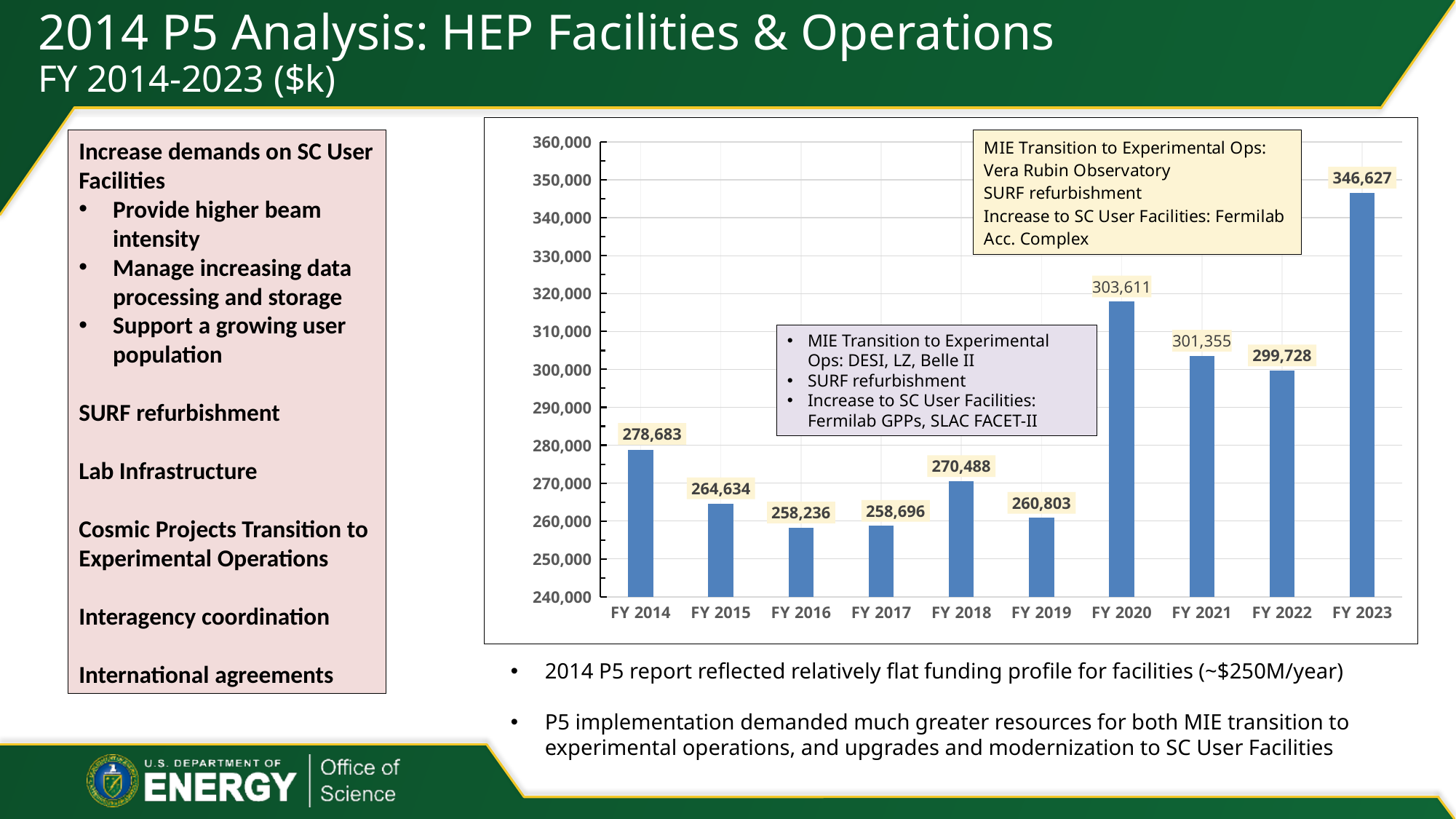
What is the value for FY 2023? 346,627 What is the value for FY 2018? 270,488 What is the value for FY 2014? 278,683 Which is larger, the value for FY 2015 or the value for FY 2019? FY 2015 What is the value for FY 2020? 303,611 Which fiscal year has the lowest value? FY 2016 What kind of chart is shown on the slide? bar chart What is the difference between the FY 2023 value and the FY 2014 value? 67,944 Do the values rise or fall from FY 2020 to FY 2022? fall How many fiscal years are shown on the x axis? 10 Is the value for FY 2014 greater or less than 270,000? greater Which fiscal year has the highest value? FY 2023